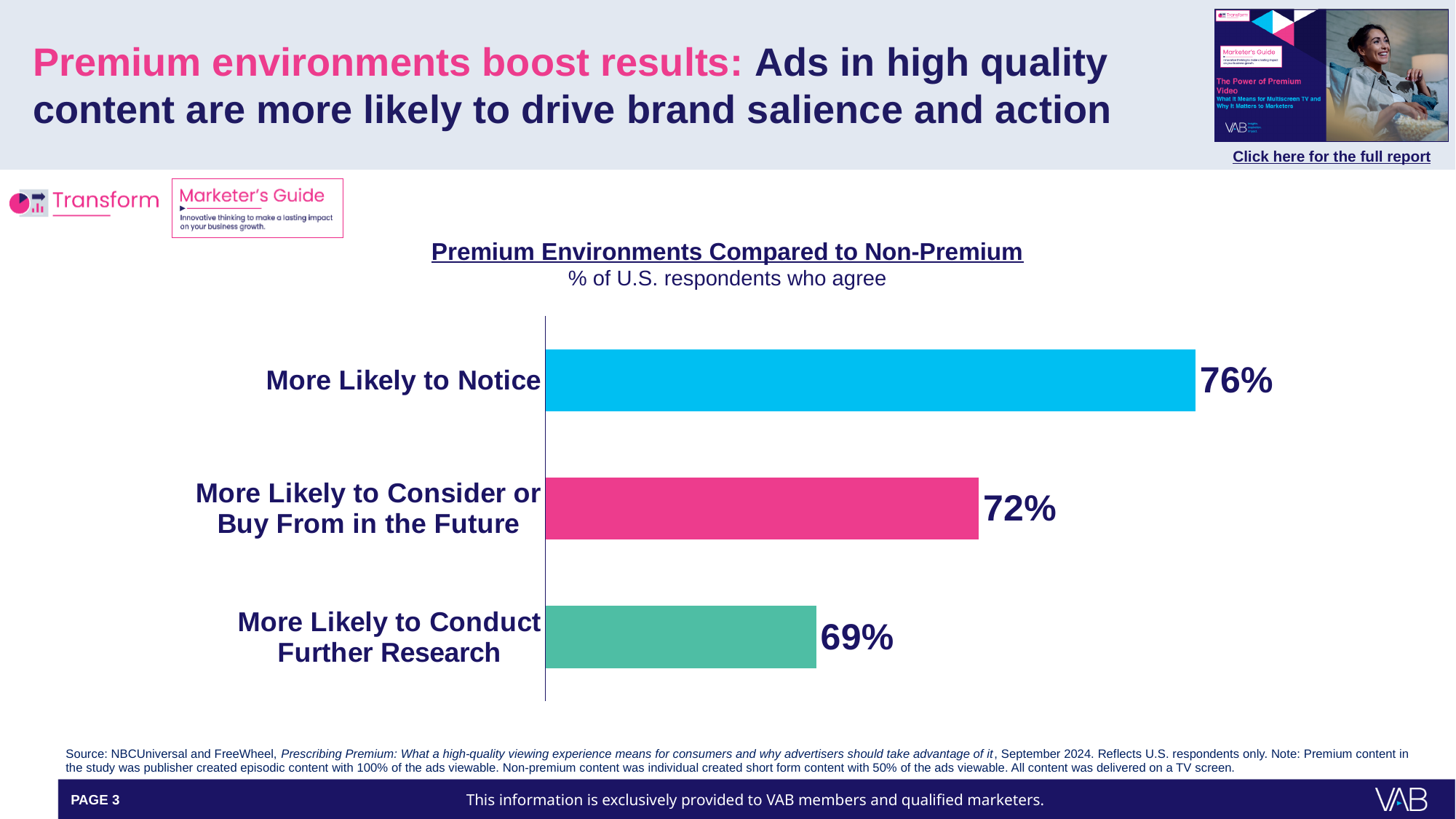
What is the difference between 'More Likely to Notice' and 'More Likely to Consider or Buy From in the Future'? 4% What is the value for 'More Likely to Consider or Buy From in the Future'? 72% Which category has the highest value in the chart? More Likely to Notice What is the title of the chart? Premium Environments Compared to Non-Premium What type of chart is shown on the slide? Bar chart What is the value for 'More Likely to Conduct Further Research'? 69% What percentage of U.S. respondents agree they are more likely to notice ads in premium environments? 76% Which category has the lowest value in the chart? More Likely to Conduct Further Research What colour is the bar for 'More Likely to Consider or Buy From in the Future'? Pink What is the difference between 'More Likely to Notice' and 'More Likely to Conduct Further Research'? 7% Which is larger: 'More Likely to Consider or Buy From in the Future' or 'More Likely to Conduct Further Research'? More Likely to Consider or Buy From in the Future How many categories are shown in the chart? 3